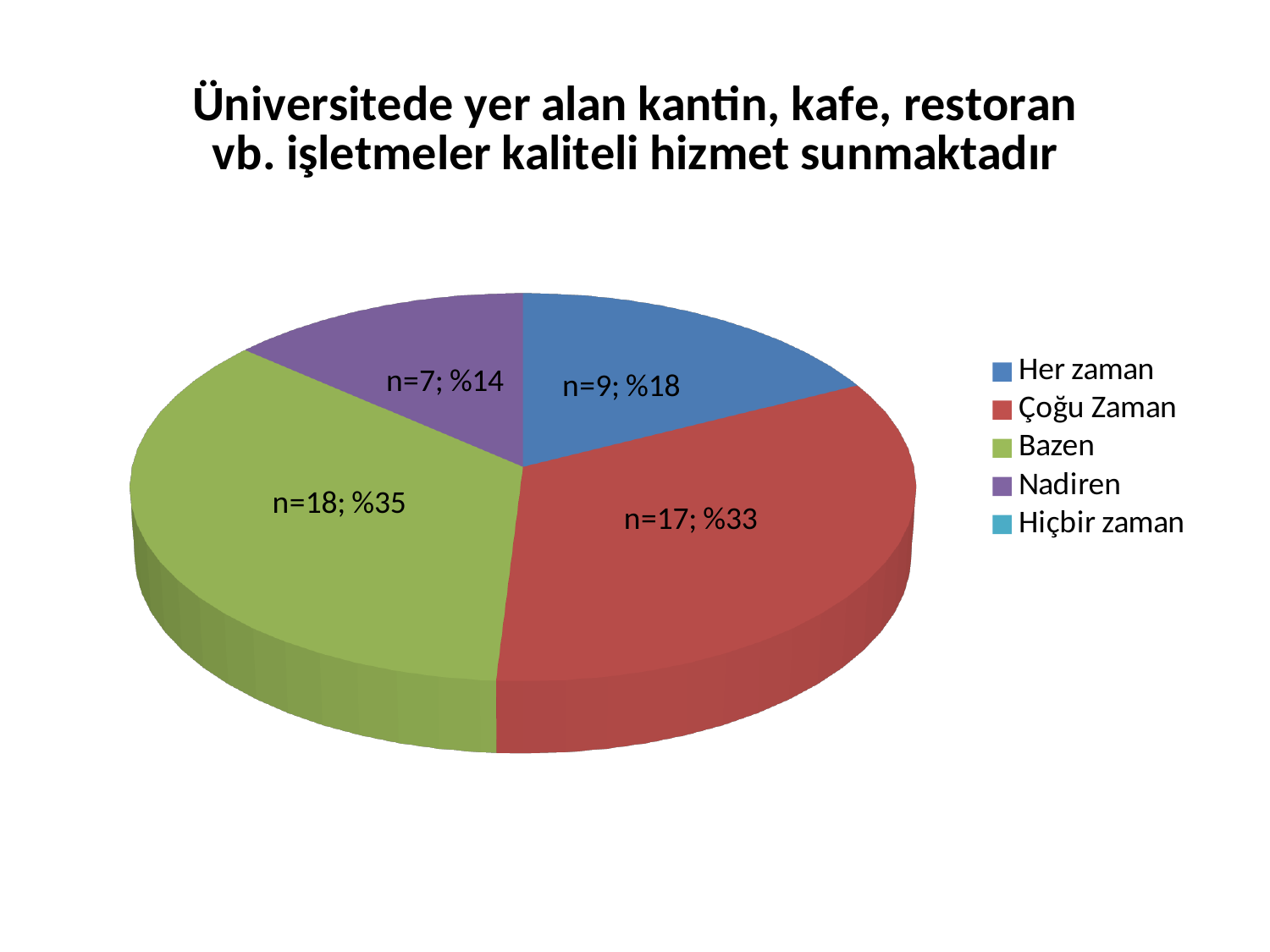
What is the count (n) for the Bazen slice? n=18 What kind of chart is shown on the slide? pie chart How many entries does the legend list? 5 What percentage is shown for the Çoğu Zaman slice? %33 What share of the pie does the Her zaman slice represent? %18 What is the difference in percentage points between the Bazen slice and the Nadiren slice? 21 Which category has the largest slice of the pie? Bazen What is the count (n) for the Her zaman slice? n=9 What percentage is shown for the Nadiren slice? %14 Which legend entry has no visible slice in the pie? Hiçbir zaman Among the slices with printed labels, which category has the smallest slice? Nadiren Which is larger, the count for Bazen or the count for Çoğu Zaman? Bazen